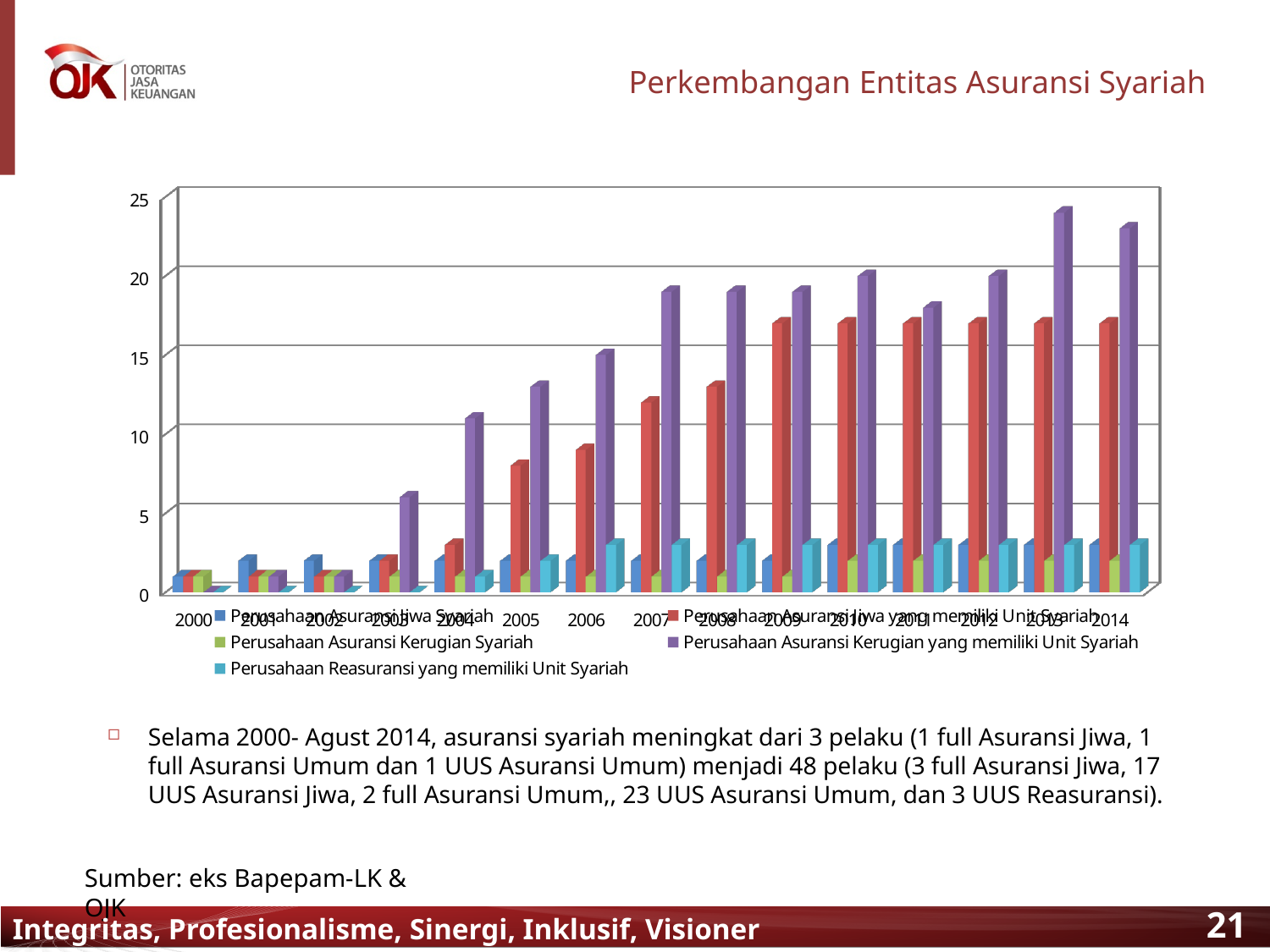
In which year is the bar for Perusahaan Asuransi Kerugian yang memiliki Unit Syariah the highest? 2013 In 2014, which is larger: Perusahaan Asuransi Kerugian yang memiliki Unit Syariah or Perusahaan Asuransi Jiwa yang memiliki Unit Syariah? Perusahaan Asuransi Kerugian yang memiliki Unit Syariah Do the values for Perusahaan Asuransi Kerugian yang memiliki Unit Syariah generally rise or fall from 2000 to 2013? rise What kind of chart is shown on the slide? bar chart What is the title of the chart slide? Perkembangan Entitas Asuransi Syariah In 2004, which is larger: Perusahaan Asuransi Kerugian yang memiliki Unit Syariah or Perusahaan Asuransi Jiwa yang memiliki Unit Syariah? Perusahaan Asuransi Kerugian yang memiliki Unit Syariah Is the value for Perusahaan Asuransi Kerugian yang memiliki Unit Syariah in 2003 greater or less than 10? less Is the value for Perusahaan Asuransi Kerugian yang memiliki Unit Syariah in 2013 greater or less than 20? greater How many years are shown along the x axis of the chart? 15 Is the value for Perusahaan Asuransi Jiwa yang memiliki Unit Syariah in 2014 greater or less than 15? greater How many series does the chart legend list? 5